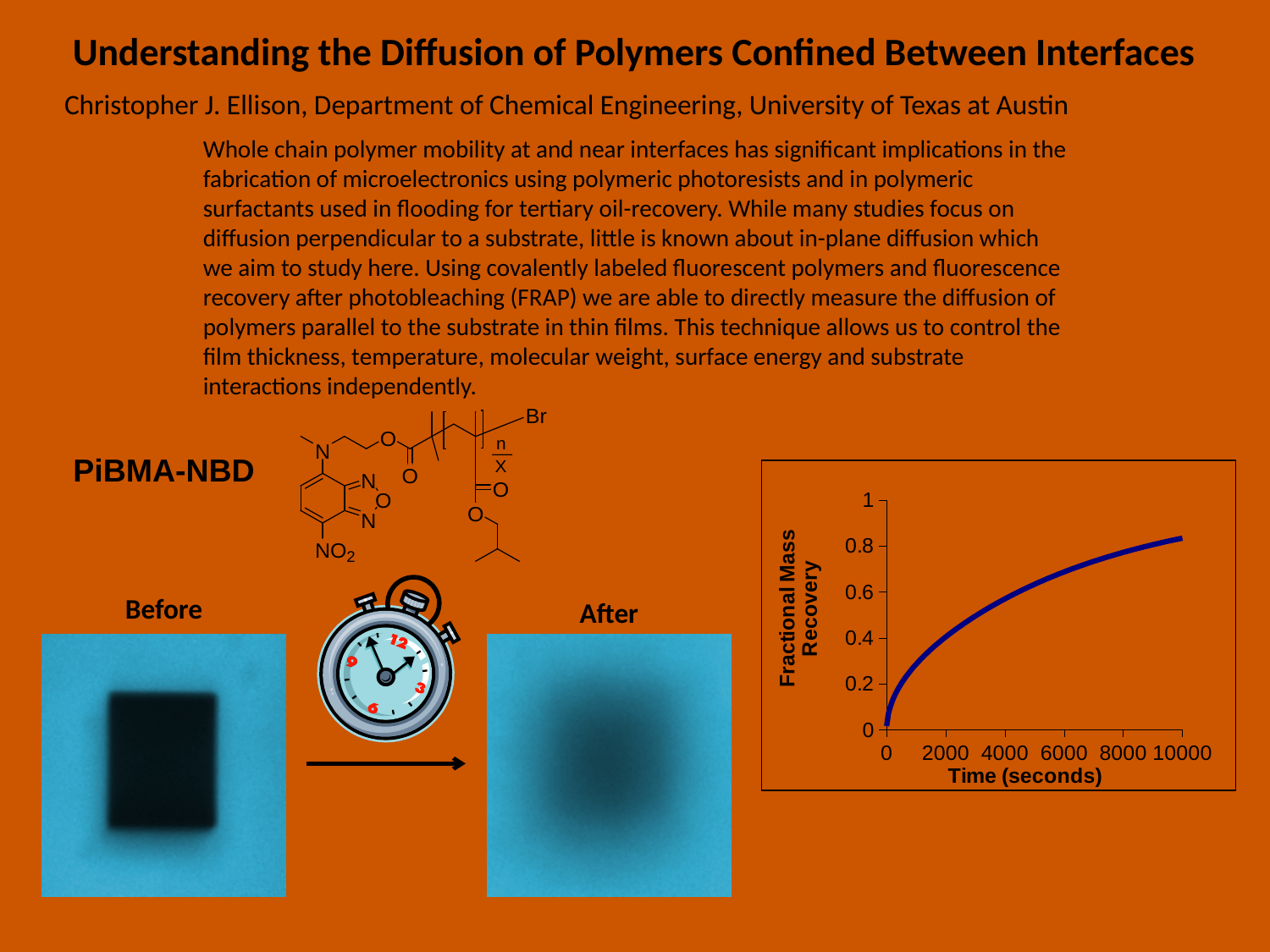
How many lines are plotted on the chart? 1 What is the label of the y axis of the chart? Fractional Mass Recovery What kind of chart is shown on the slide? line chart Is the fractional mass recovery at 6000 seconds greater or less than 0.6? greater Does the fractional mass recovery rise or fall as time increases? rise Is the fractional mass recovery at 10000 seconds greater or less than 0.6? greater Is the fractional mass recovery at 2000 seconds greater or less than 0.6? less What is the label of the x axis of the chart? Time (seconds) What is the largest time value marked on the x axis? 10000